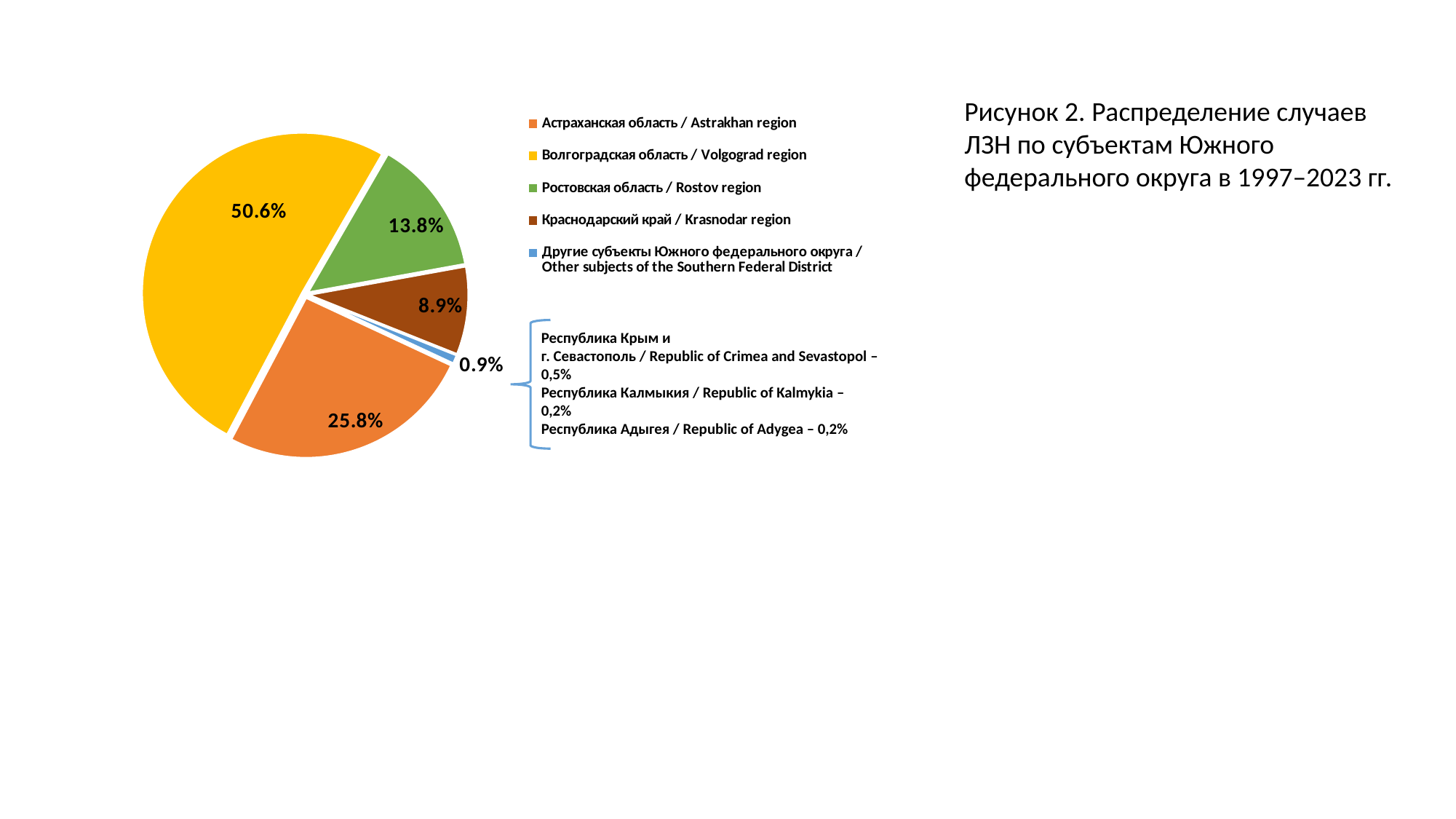
What share of the pie does the Astrakhan region slice have? 25.8% What share of the pie does the Rostov region slice have? 13.8% How many slices does the pie chart have? 5 What colour is the Rostov region slice in the pie chart? Green Which region has the largest slice of the pie? Volgograd region What share of the pie does the Volgograd region slice have? 50.6% What is the difference in percentage points between the Volgograd region and Astrakhan region slices? 24.8 Which slice is larger, Rostov region or Krasnodar region? Rostov region What share of the pie does the 'Other subjects of the Southern Federal District' slice have? 0.9% Which slice of the pie is the smallest? Other subjects of the Southern Federal District What share of the pie does the Krasnodar region slice have? 8.9% What kind of chart is shown on the slide? Pie chart